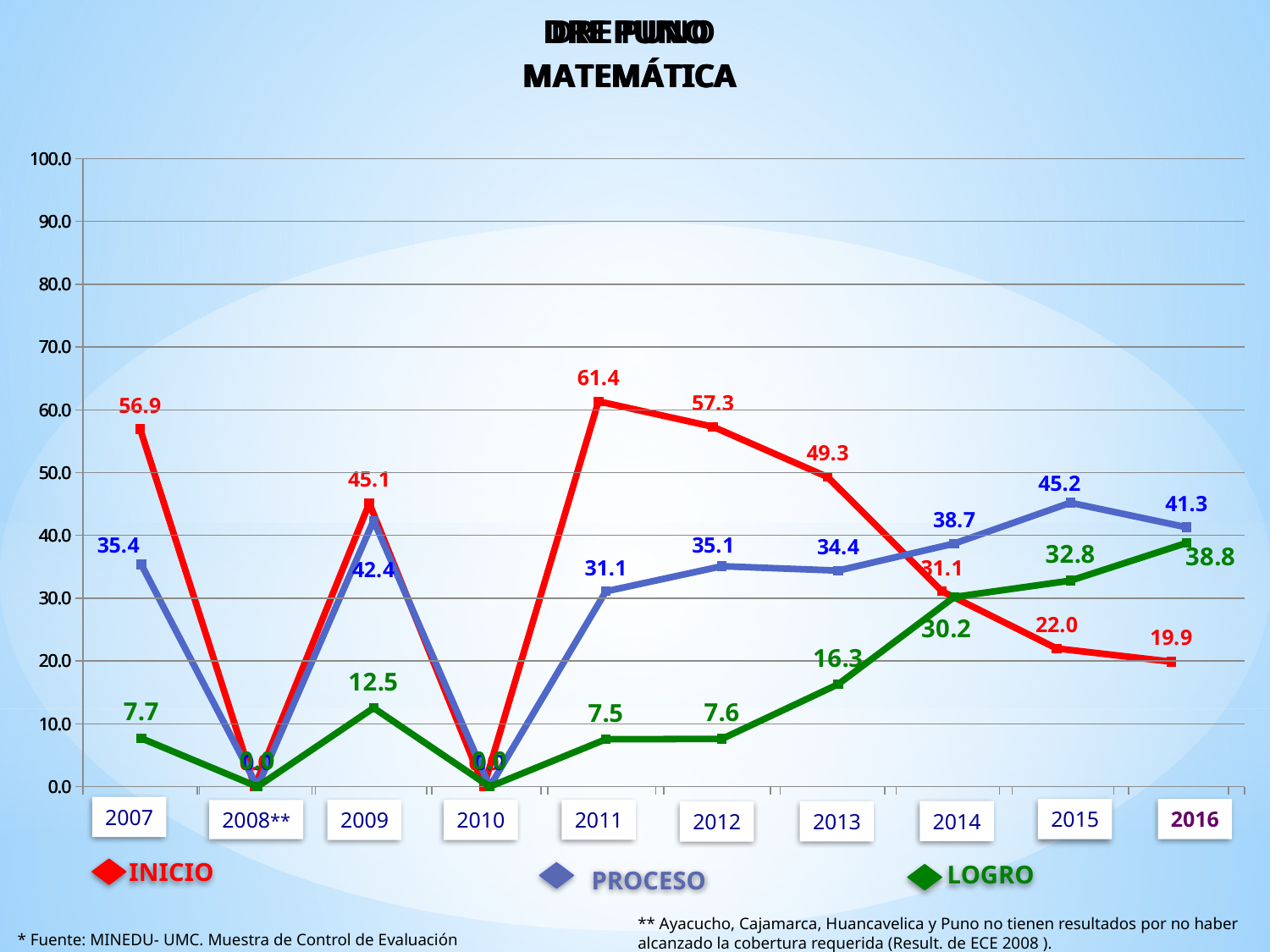
How many years are shown on the x axis? 10 What is the INICIO value for 2011? 61.4 What colour is the line for the LOGRO series? green Does the LOGRO series rise or fall from 2013 to 2016? rise What is the LOGRO value for 2016? 38.8 How many series does the legend list? 3 In which year does the INICIO series reach its highest value? 2011 Which series has the lowest value in 2007? LOGRO What is the PROCESO value for 2015? 45.2 What type of chart is shown on the slide? line chart What is the difference between the INICIO values for 2011 and 2016? 41.5 Which is larger in 2016, the PROCESO value or the INICIO value? PROCESO